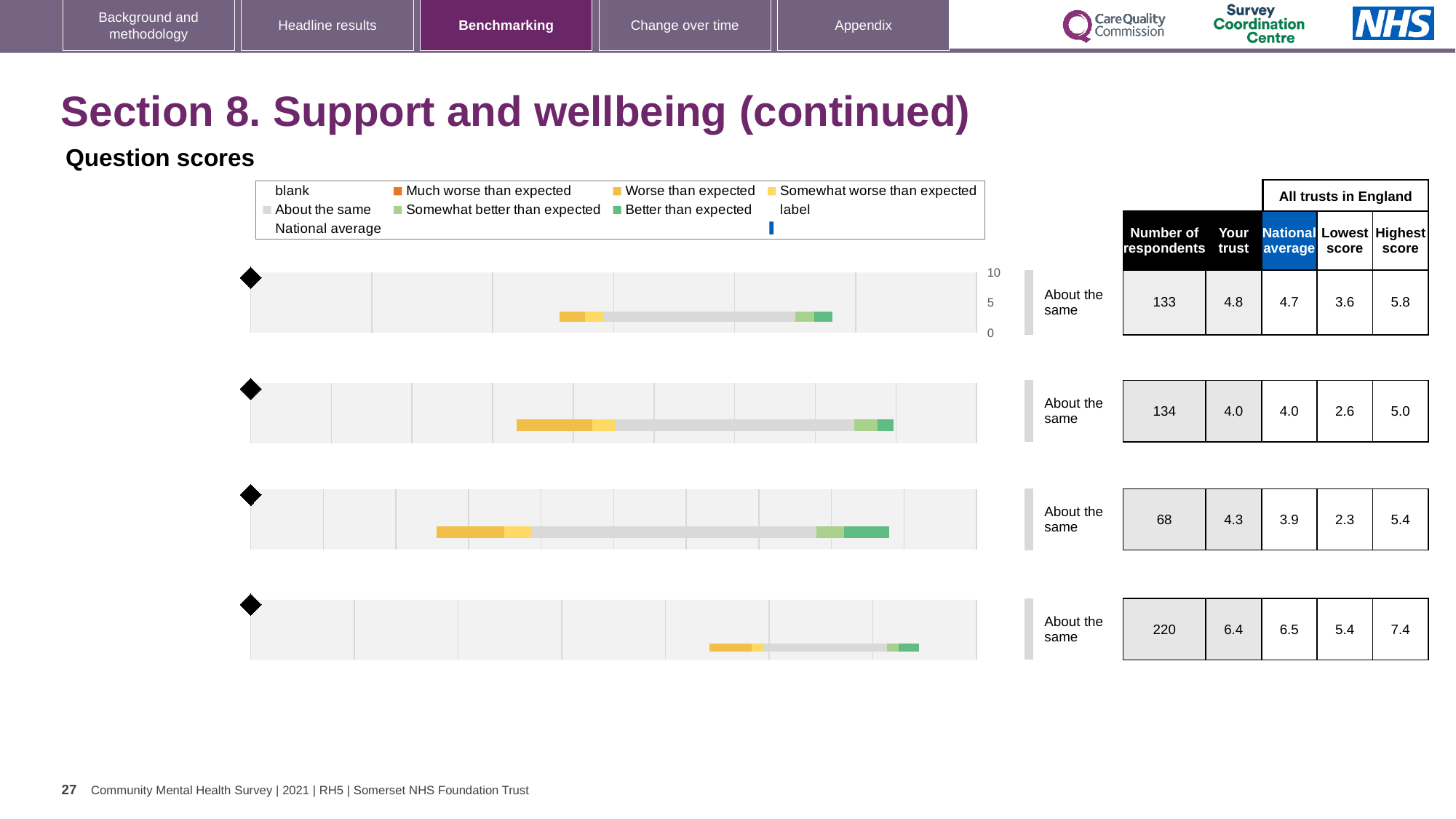
Which chart has the highest 'Your trust' score? the fourth (bottom) chart (6.4) How many question score charts are shown on the slide? 4 For the fourth (bottom) chart, what is the difference between the highest score and the lowest score? 2.0 For the second chart, what is the national average score? 4.0 What kind of chart is used for the question scores on this slide? bar chart For the first (top) chart, what is the 'Your trust' score? 4.8 For the third chart, which is larger: the 'Your trust' score or the national average? Your trust Which legend entry is shown in orange? Much worse than expected For the fourth (bottom) chart, what is the highest score among all trusts in England? 7.4 For the third chart, what is the lowest score among all trusts in England? 2.3 Which chart has the lowest number of respondents? the third chart (68) For the first (top) chart, what is the number of respondents? 133